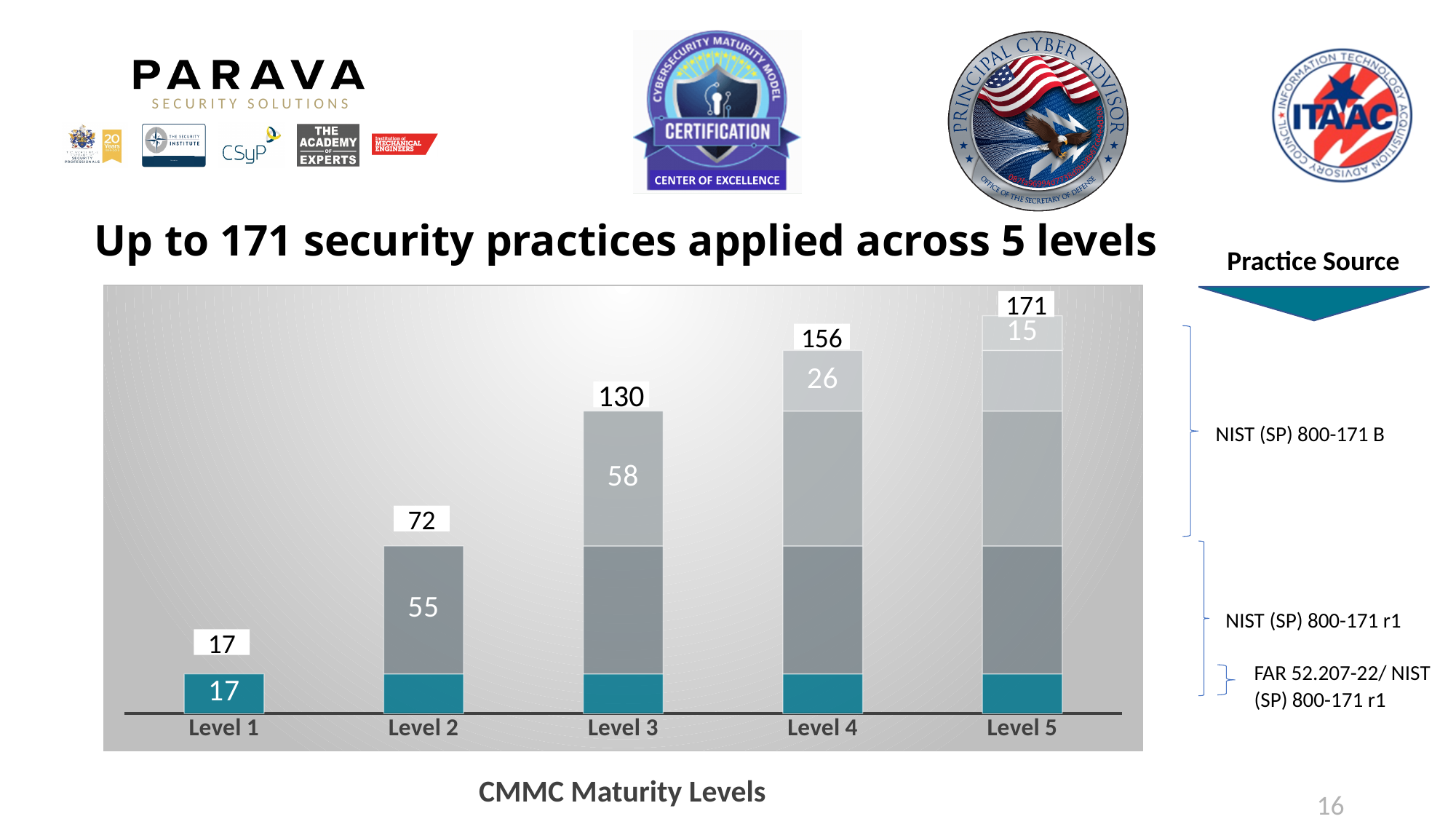
How many maturity levels are shown on the x axis of the chart? 5 What is the total number of security practices shown for Level 3? 130 What is the difference between the total practices at Level 4 and Level 3? 26 What value is labelled on the top segment of the Level 4 bar? 26 What is the x-axis title of the chart? CMMC Maturity Levels Which CMMC maturity level has the lowest total number of practices? Level 1 What kind of chart is used to show the security practices across levels? Stacked bar chart Which has a larger total of practices, Level 2 or Level 3? Level 3 What is the total number of security practices shown for Level 5? 171 Do the total practices rise or fall from Level 1 to Level 5? Rise What value is labelled on the top segment of the Level 2 bar? 55 Which CMMC maturity level has the highest total number of practices? Level 5